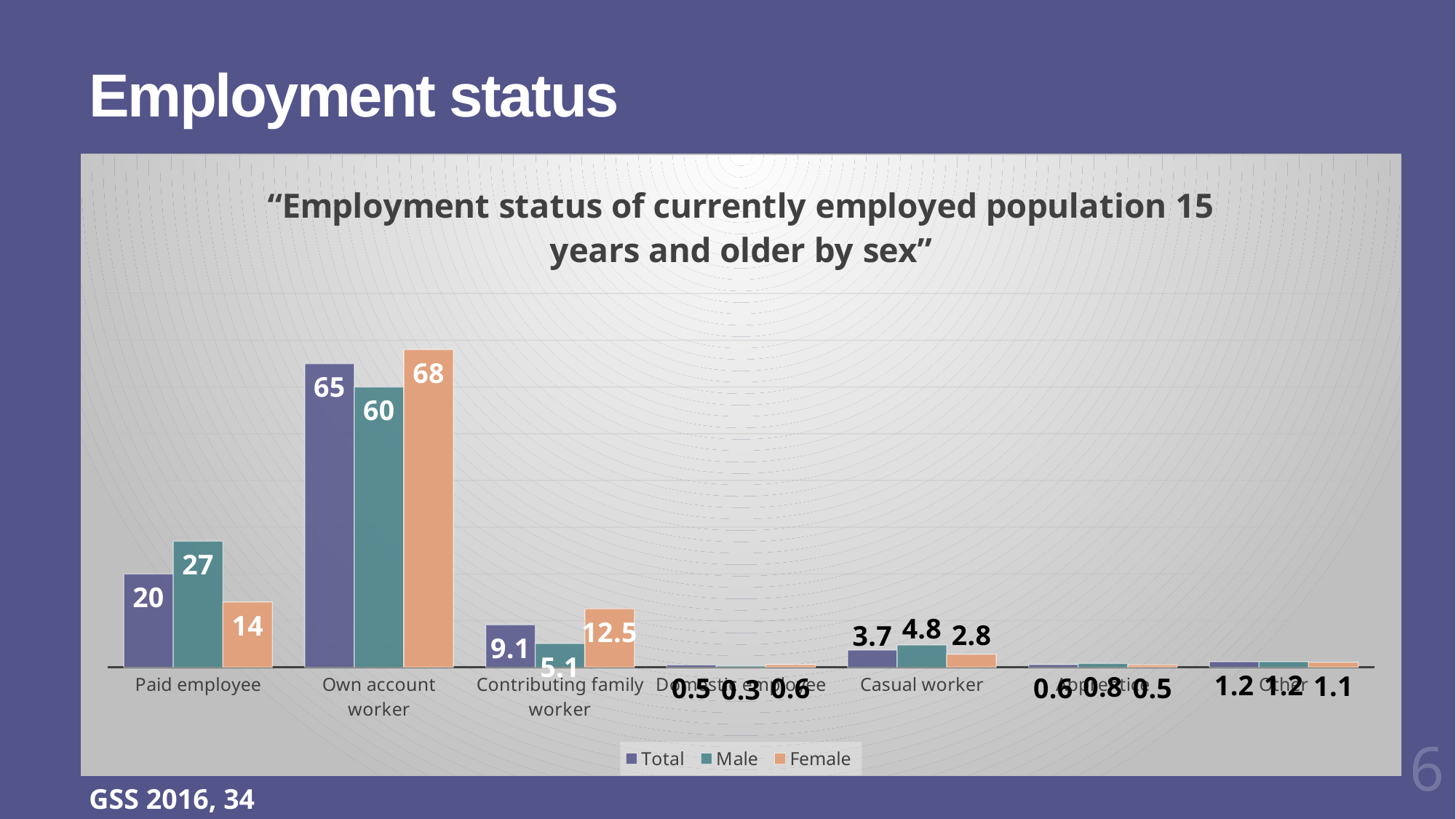
What type of chart is shown on the slide? bar chart For Own account worker, which is larger, the Male value or the Female value? Female What is the Male value for Paid employee? 27 Which category has the highest Total value? Own account worker What is the Total value for Contributing family worker? 9.1 What is the Male value for Casual worker? 4.8 What is the difference between the Male and Female values for Paid employee? 13 Which series is shown in orange in the legend? Female How many series does the legend list? 3 What is the difference between the Female and Male values for Contributing family worker? 7.4 How many categories are shown on the x axis? 7 What is the Female value for Own account worker? 68